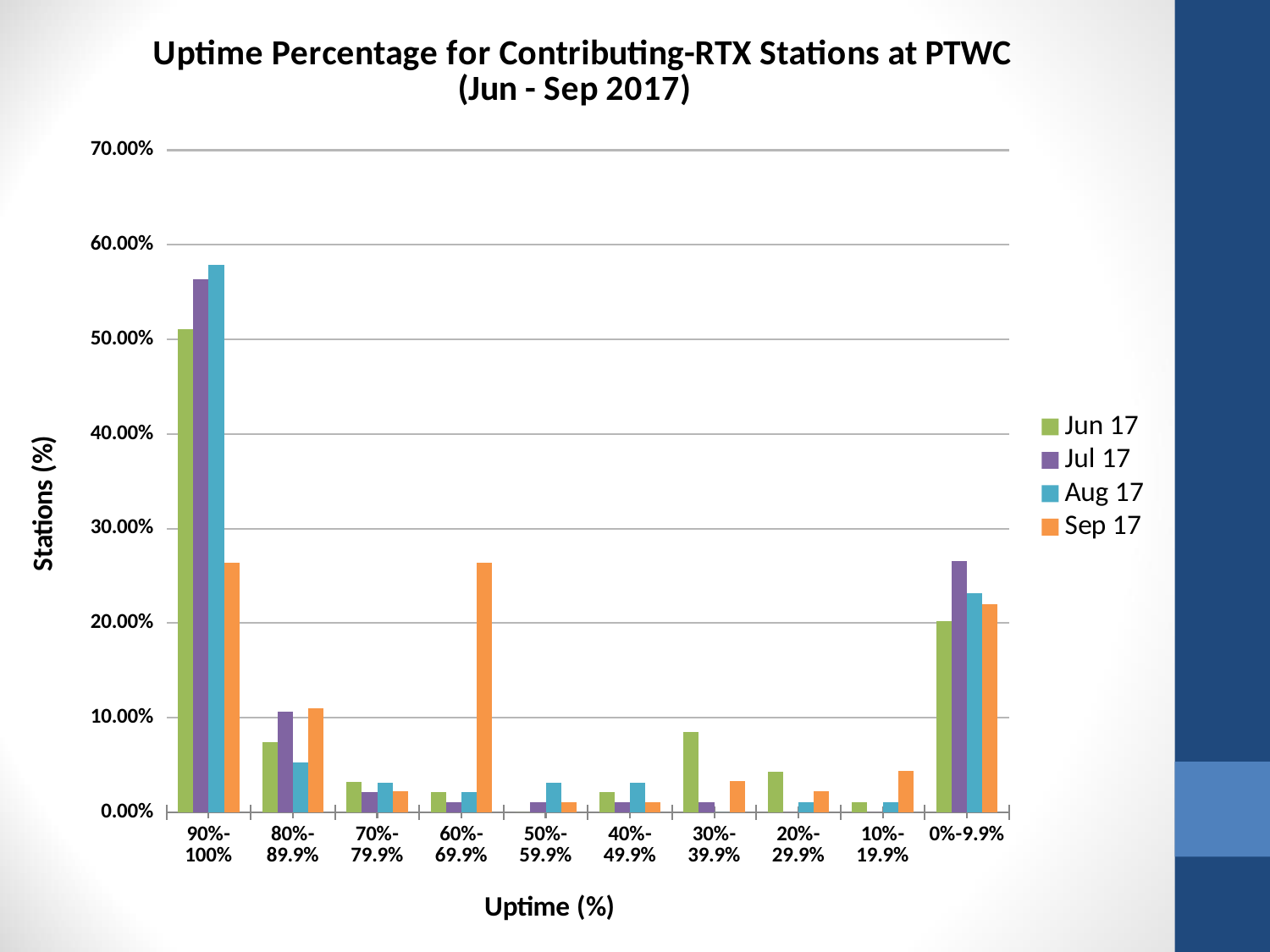
Is the value for Aug 17 in the 90%-100% category greater or less than 50.00%? greater Which series has the highest value in the 0%-9.9% category? Jul 17 Is the value for Sep 17 in the 60%-69.9% category greater or less than 20.00%? greater Which series has the highest value in the 90%-100% category? Aug 17 In the 60%-69.9% category, which is larger: the value for Sep 17 or the value for Jun 17? Sep 17 How many series does the legend list? 4 What is the title of the x axis? Uptime (%) What kind of chart is shown on the slide? bar chart Is the value for Sep 17 in the 90%-100% category greater or less than 30.00%? less How many uptime categories are shown on the x axis? 10 Which series has the highest value in the 30%-39.9% category? Jun 17 What is the title of the y axis? Stations (%)